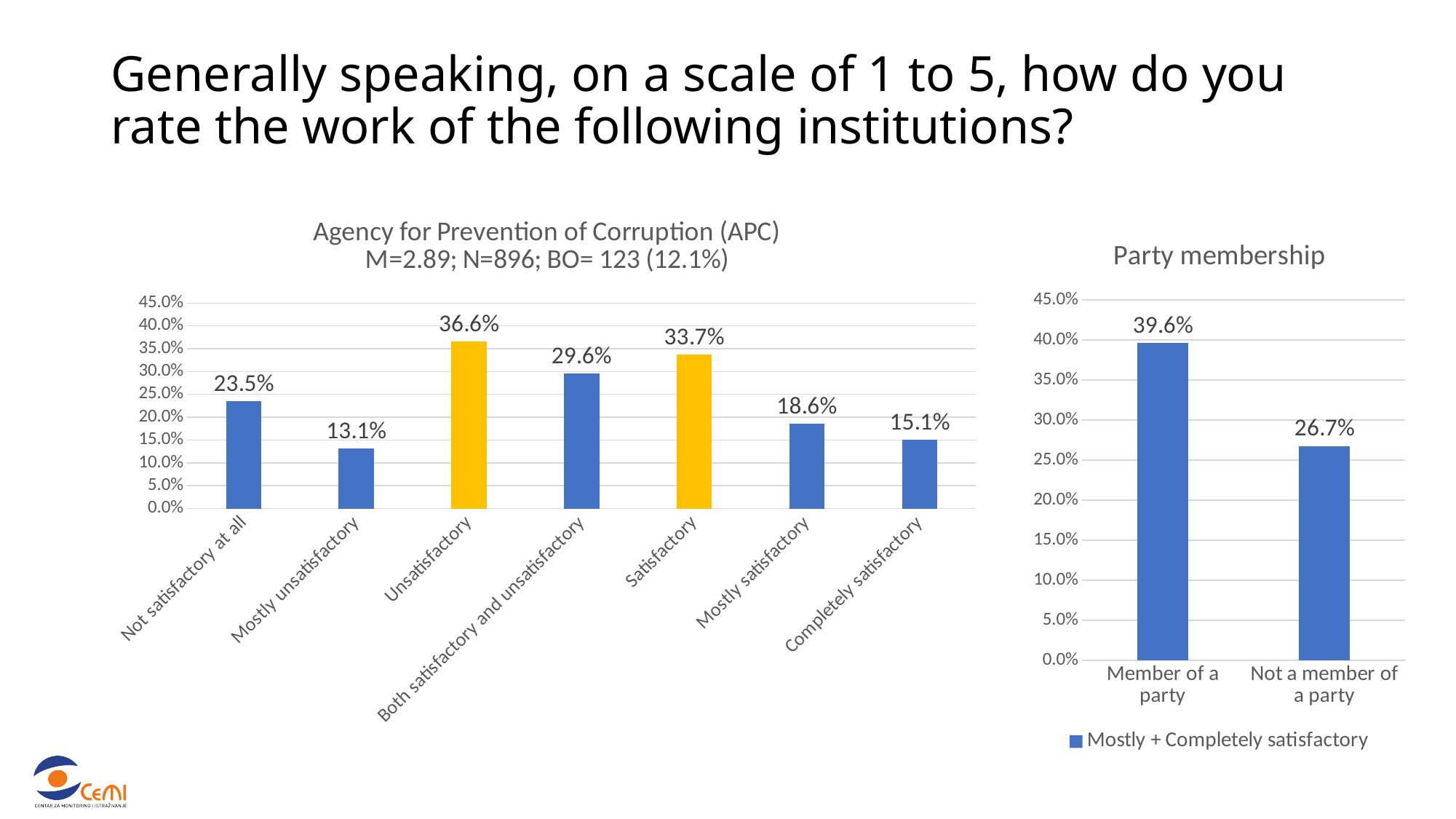
In the Party membership chart, what is the value for Member of a party? 39.6% In the Agency for Prevention of Corruption (APC) chart, what is the difference between Satisfactory and Not satisfactory at all? 10.2% In the Agency for Prevention of Corruption (APC) chart, what is the value for Unsatisfactory? 36.6% How many categories are shown in the Agency for Prevention of Corruption (APC) chart? 7 In the Agency for Prevention of Corruption (APC) chart, which is larger: Both satisfactory and unsatisfactory or Completely satisfactory? Both satisfactory and unsatisfactory In the Party membership chart, what is the difference between Member of a party and Not a member of a party? 12.9% In the Agency for Prevention of Corruption (APC) chart, which two categories are shown with yellow bars? Unsatisfactory and Satisfactory In the Agency for Prevention of Corruption (APC) chart, what is the value for Mostly satisfactory? 18.6% What series does the legend of the Party membership chart list? Mostly + Completely satisfactory What kind of chart is the Party membership chart? Bar chart In the Agency for Prevention of Corruption (APC) chart, which category has the highest value? Unsatisfactory In the Agency for Prevention of Corruption (APC) chart, which category has the lowest value? Mostly unsatisfactory